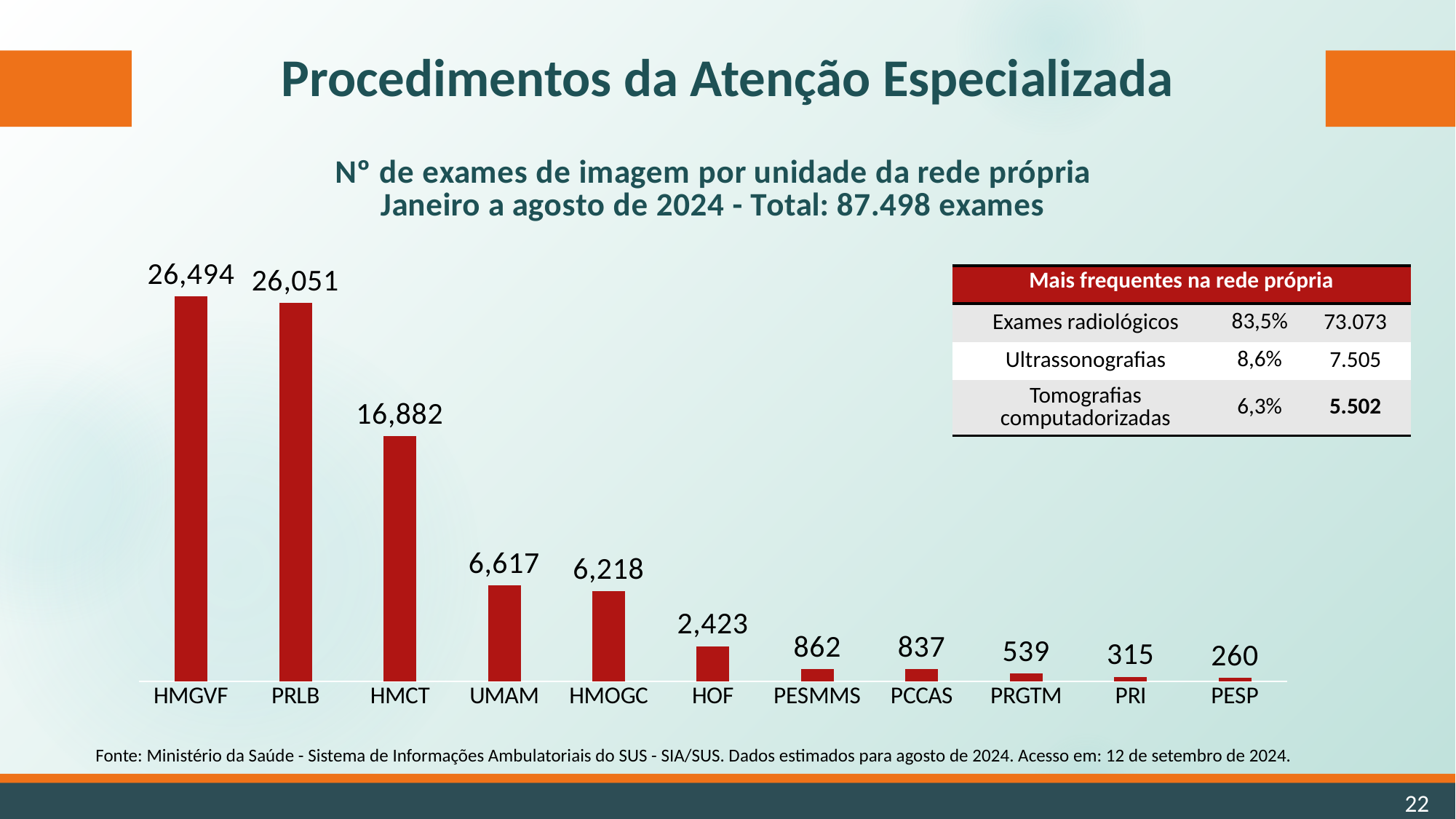
Do the values rise or fall from left to right along the x axis? Fall Which unit has the lowest number of imaging exams? PESP What kind of chart is shown on the slide? Bar chart What is the difference between the values for HMGVF and PRLB? 443 What is the value shown for PRGTM? 539 What is the number of imaging exams for HOF? 2,423 Which unit has the highest number of imaging exams? HMGVF What is the difference between the values for HMCT and UMAM? 10,265 Which has a higher value, UMAM or HMOGC? UMAM Which has a higher value, PRI or PESP? PRI How many units are shown on the x axis of the chart? 11 What is the number of imaging exams for HMCT? 16,882